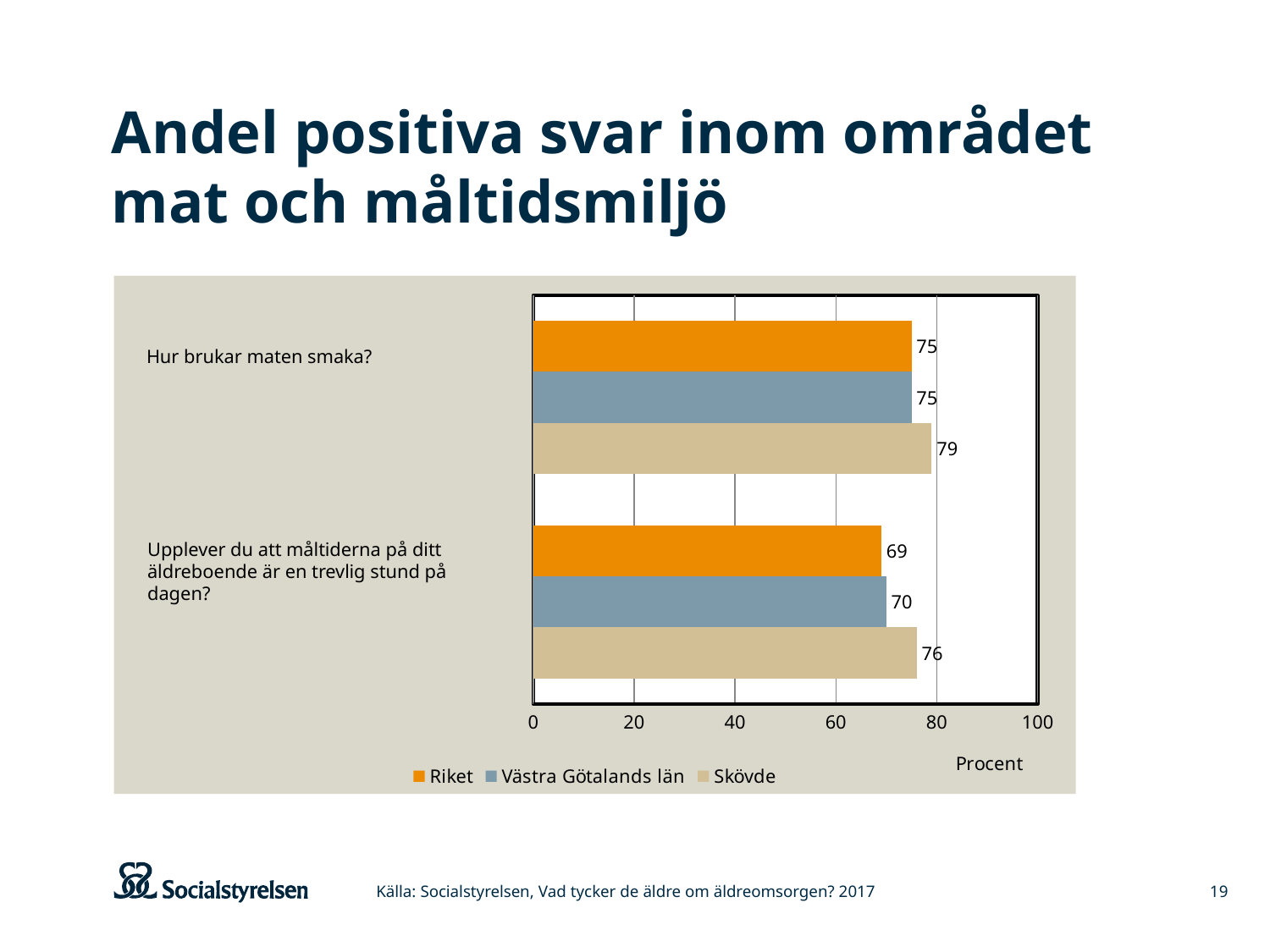
What is the value for Riket for "Upplever du att måltiderna på ditt äldreboende är en trevlig stund på dagen?"? 69 What is the value for Skövde for "Hur brukar maten smaka?"? 79 Which series has the highest value for "Upplever du att måltiderna på ditt äldreboende är en trevlig stund på dagen?"? Skövde How many series does the legend list? 3 What unit is shown on the x axis of the chart? Procent Is the Skövde value for "Hur brukar maten smaka?" larger or smaller than the Skövde value for "Upplever du att måltiderna på ditt äldreboende är en trevlig stund på dagen?"? larger What is the difference between the Skövde value and the Västra Götalands län value for "Upplever du att måltiderna på ditt äldreboende är en trevlig stund på dagen?"? 6 How many question categories are shown on the chart? 2 Which series has the lowest value for "Upplever du att måltiderna på ditt äldreboende är en trevlig stund på dagen?"? Riket What kind of chart is shown on the slide? bar chart What is the difference between the Skövde value and the Riket value for "Hur brukar maten smaka?"? 4 What is the value for Västra Götalands län for "Hur brukar maten smaka?"? 75